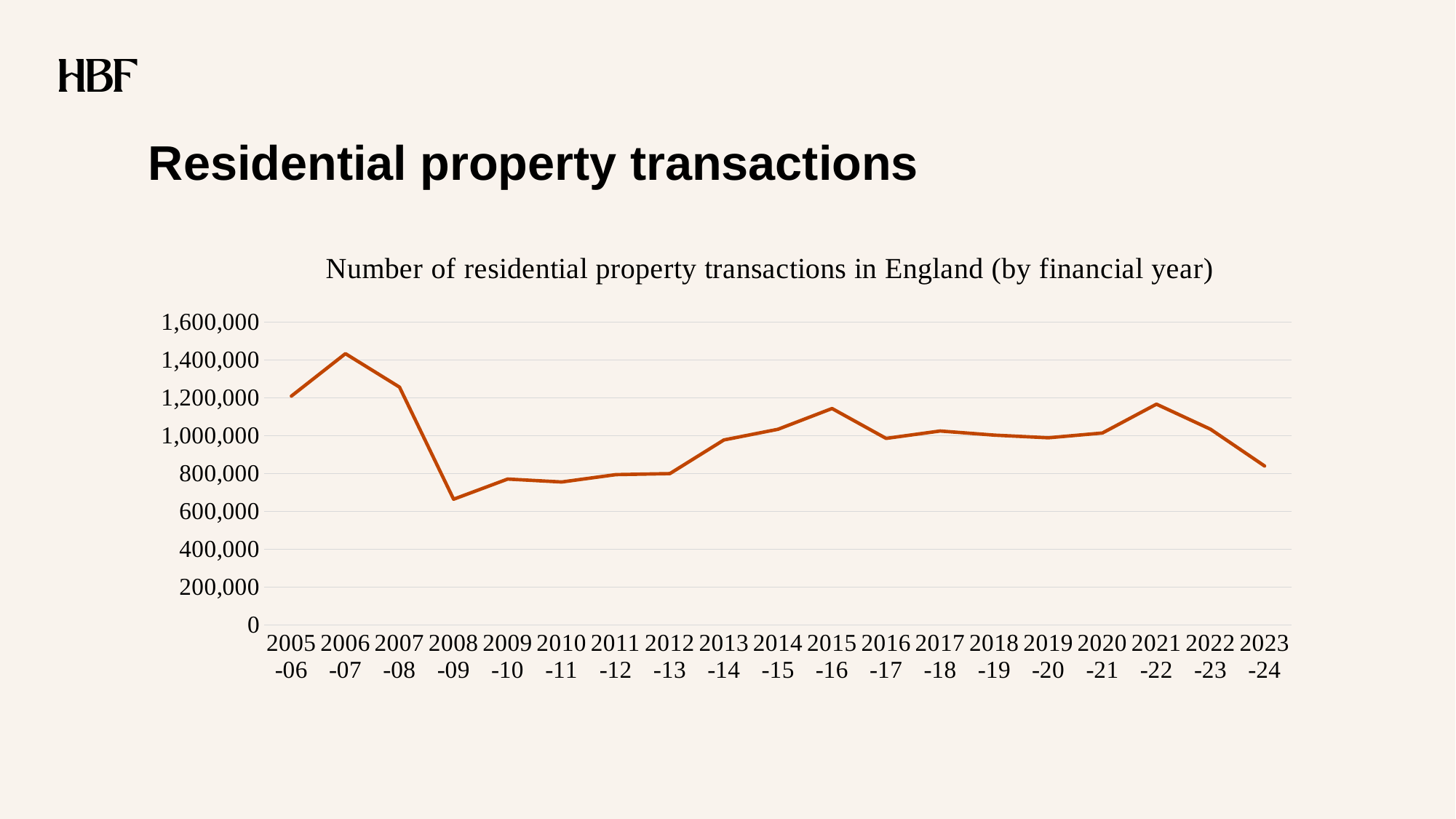
How many financial years are plotted on the x axis? 19 Which financial year has the highest number of transactions? 2006-07 Is the value for 2023-24 greater or less than 1,000,000? less Is the value for 2015-16 greater or less than 1,000,000? greater What kind of chart is shown on the slide? line chart Do the values rise or fall from 2021-22 to 2023-24? fall Is the value for 2006-07 greater or less than 1,400,000? greater Which financial year has the lowest number of transactions? 2008-09 Which is larger, the value for 2021-22 or the value for 2023-24? 2021-22 Which is larger, the value for 2005-06 or the value for 2009-10? 2005-06 What is the title of the chart? Number of residential property transactions in England (by financial year)